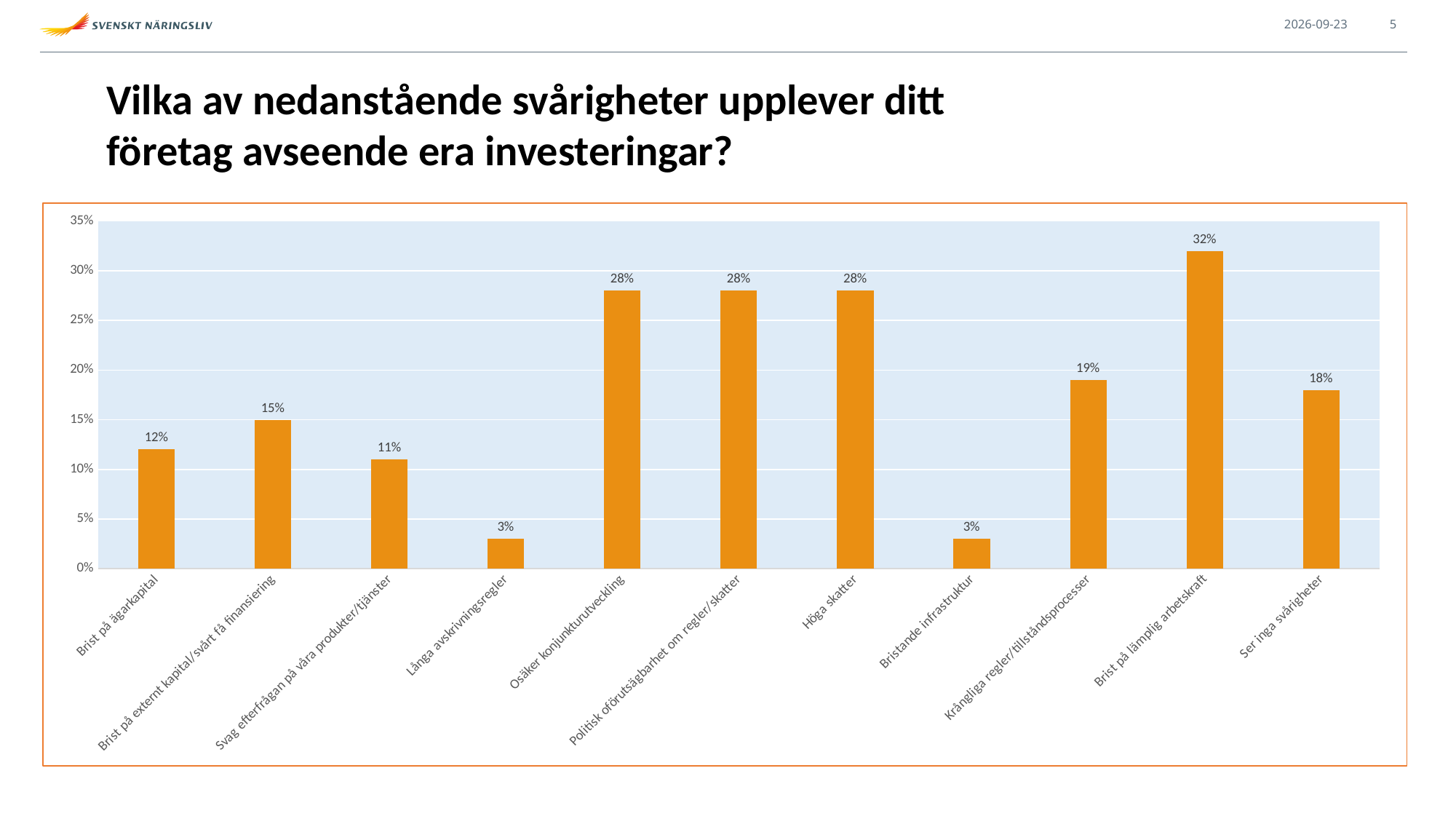
Which category has the highest value? Brist på lämplig arbetskraft What is the value for Brist på lämplig arbetskraft? 32% Is the value for Osäker konjunkturutveckling greater or less than 25%? greater What is the difference between Brist på externt kapital/svårt få finansiering and Brist på ägarkapital? 3% What is the value for Krångliga regler/tillståndsprocesser? 19% What is the value for Svag efterfrågan på våra produkter/tjänster? 11% What is the difference between Brist på lämplig arbetskraft and Höga skatter? 4% What is the value for Ser inga svårigheter? 18% Which is larger, Krångliga regler/tillståndsprocesser or Ser inga svårigheter? Krångliga regler/tillståndsprocesser What kind of chart is shown on the slide? Bar chart How many categories are shown on the x axis? 11 How many categories have a value of 28%? 3